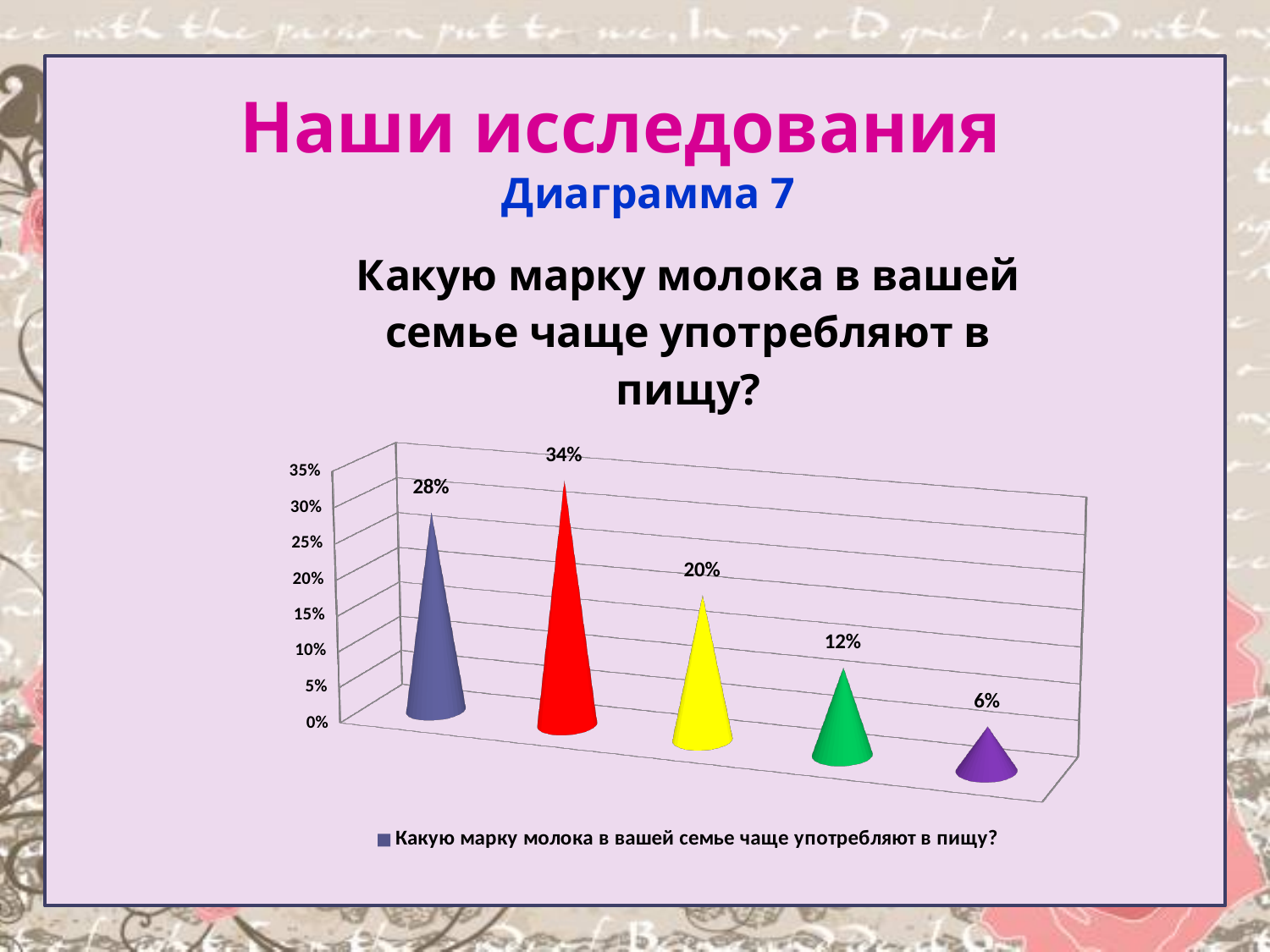
How many series does the chart legend list? 1 How many cones (data points) are plotted in the chart? 5 Which is larger: the value of the yellow cone or the value of the green cone? The yellow cone (20%) What is the title of the chart? Какую марку молока в вашей семье чаще употребляют в пищу? Which cone has the lowest value in the chart? The purple cone (6%) Which cone has the highest value in the chart? The red cone (34%) What is the value shown for the green cone in the chart? 12% What is the value shown for the first (blue) cone on the left of the chart? 28% What is the difference between the red cone's value and the blue cone's value? 6% Do the values rise or fall from the third cone to the fifth cone along the x axis? Fall What is the value shown for the yellow cone in the chart? 20% What is the value shown for the red cone in the chart? 34%